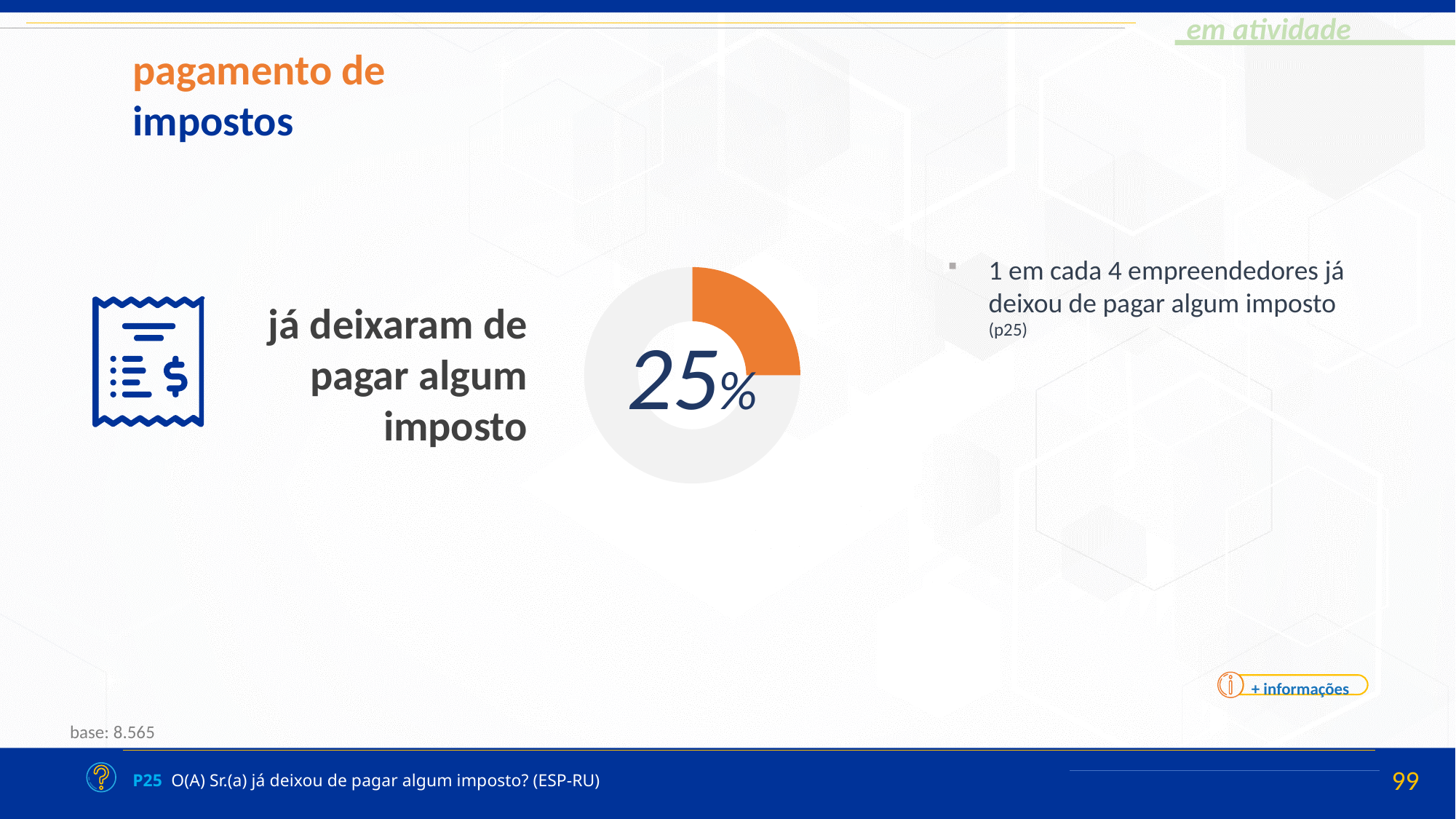
What percentage of entrepreneurs have already stopped paying some tax, according to the chart? 25% What share of the pie does the orange slice represent? 25% What colour is the highlighted slice representing those who stopped paying some tax? orange How many slices does the pie chart have? 2 What is the base (sample size) stated for the chart? 8.565 Is the value of the orange slice greater or less than 50%? less What kind of chart is shown on the slide? pie chart (donut) Which slice of the chart is larger, the orange one or the grey one? the grey one